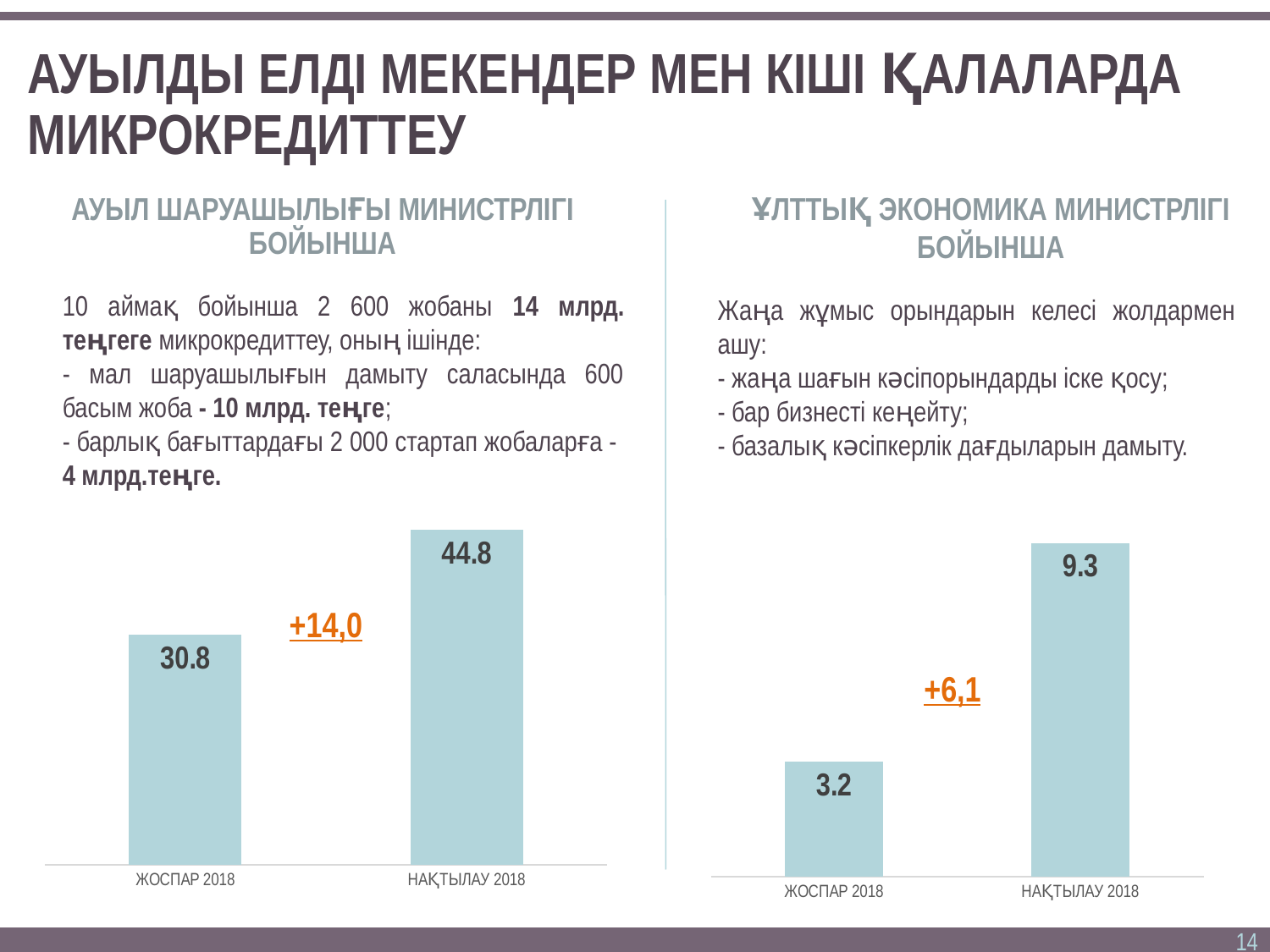
In the right chart, what is the difference between НАҚТЫЛАУ 2018 and ЖОСПАР 2018? 6.1 In the left chart (Ауыл шаруашылығы министрлігі бойынша), what is the value for ЖОСПАР 2018? 30.8 In the left chart, which category has the higher value? НАҚТЫЛАУ 2018 What change annotation is printed between the two bars of the right chart? +6,1 In the right chart, is the value for ЖОСПАР 2018 larger or smaller than the value for НАҚТЫЛАУ 2018? smaller In the right chart (Ұлттық экономика министрлігі бойынша), what is the value for НАҚТЫЛАУ 2018? 9.3 What type of chart is used on the right side of the slide? bar chart How many bars are shown in the left chart? 2 In the right chart, which category has the lower value? ЖОСПАР 2018 In the left chart (Ауыл шаруашылығы министрлігі бойынша), what is the value for НАҚТЫЛАУ 2018? 44.8 In the right chart (Ұлттық экономика министрлігі бойынша), what is the value for ЖОСПАР 2018? 3.2 In the left chart, what is the difference between НАҚТЫЛАУ 2018 and ЖОСПАР 2018? 14.0